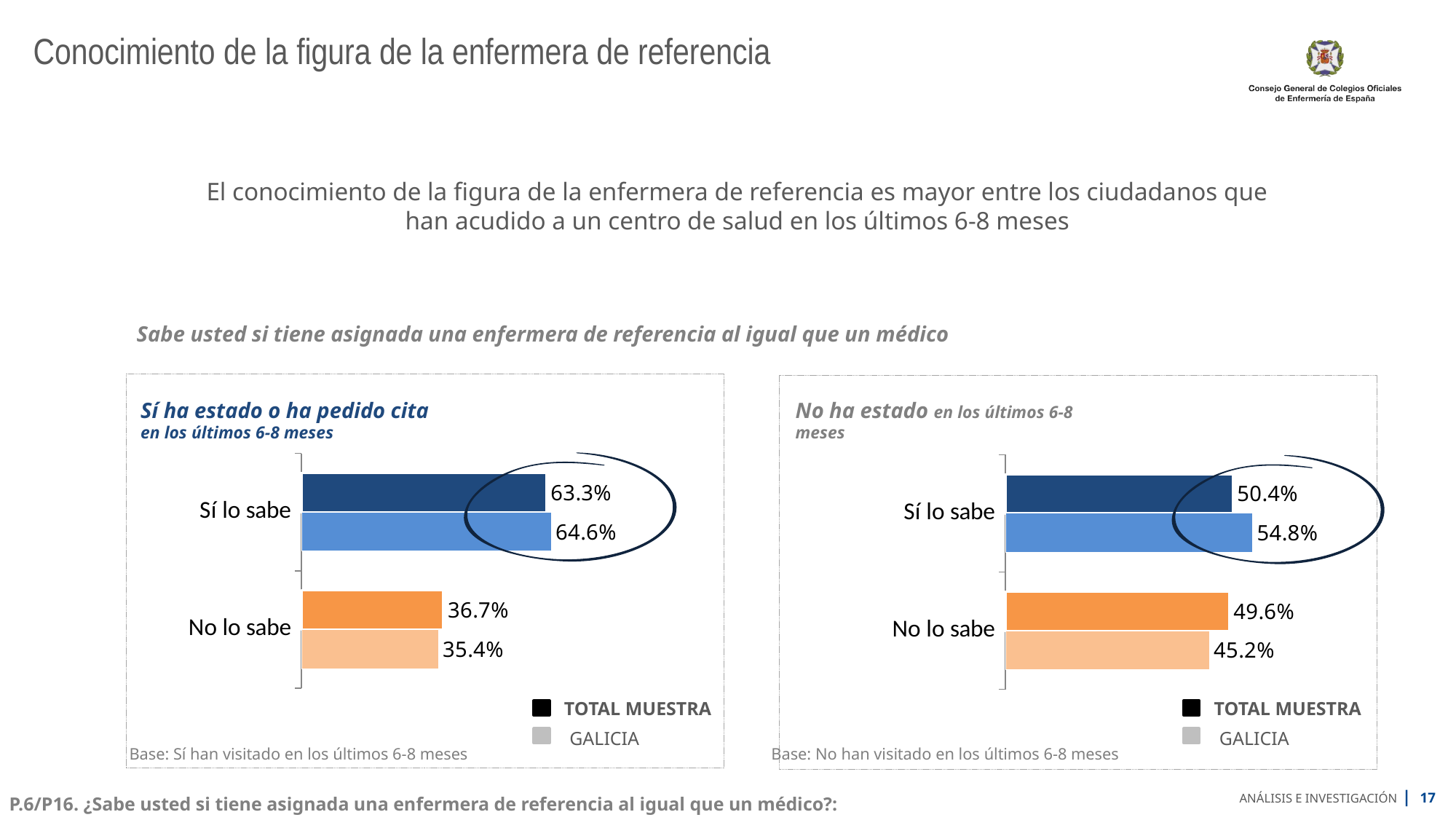
In the left chart (Sí ha estado o ha pedido cita), what is the difference between the GALICIA values for 'Sí lo sabe' and 'No lo sabe'? 29.2% In the left chart (Sí ha estado o ha pedido cita), which category has the lowest GALICIA value? No lo sabe In the right chart (No ha estado en los últimos 6-8 meses), what is the GALICIA value for 'Sí lo sabe'? 54.8% In the left chart (Sí ha estado o ha pedido cita), what is the GALICIA value for 'Sí lo sabe'? 64.6% In the right chart (No ha estado en los últimos 6-8 meses), what is the TOTAL MUESTRA value for 'No lo sabe'? 49.6% In the left chart (Sí ha estado o ha pedido cita), what is the TOTAL MUESTRA value for 'Sí lo sabe'? 63.3% What kind of chart is the left chart (Sí ha estado o ha pedido cita)? Bar chart In the right chart (No ha estado en los últimos 6-8 meses), what is the difference between the GALICIA and TOTAL MUESTRA values for 'Sí lo sabe'? 4.4% In the right chart (No ha estado en los últimos 6-8 meses), which is larger for 'No lo sabe': TOTAL MUESTRA or GALICIA? TOTAL MUESTRA How many series does the legend of the left chart list? 2 How many categories are shown in the right chart (No ha estado en los últimos 6-8 meses)? 2 In the right chart (No ha estado en los últimos 6-8 meses), which category has the highest value overall? Sí lo sabe